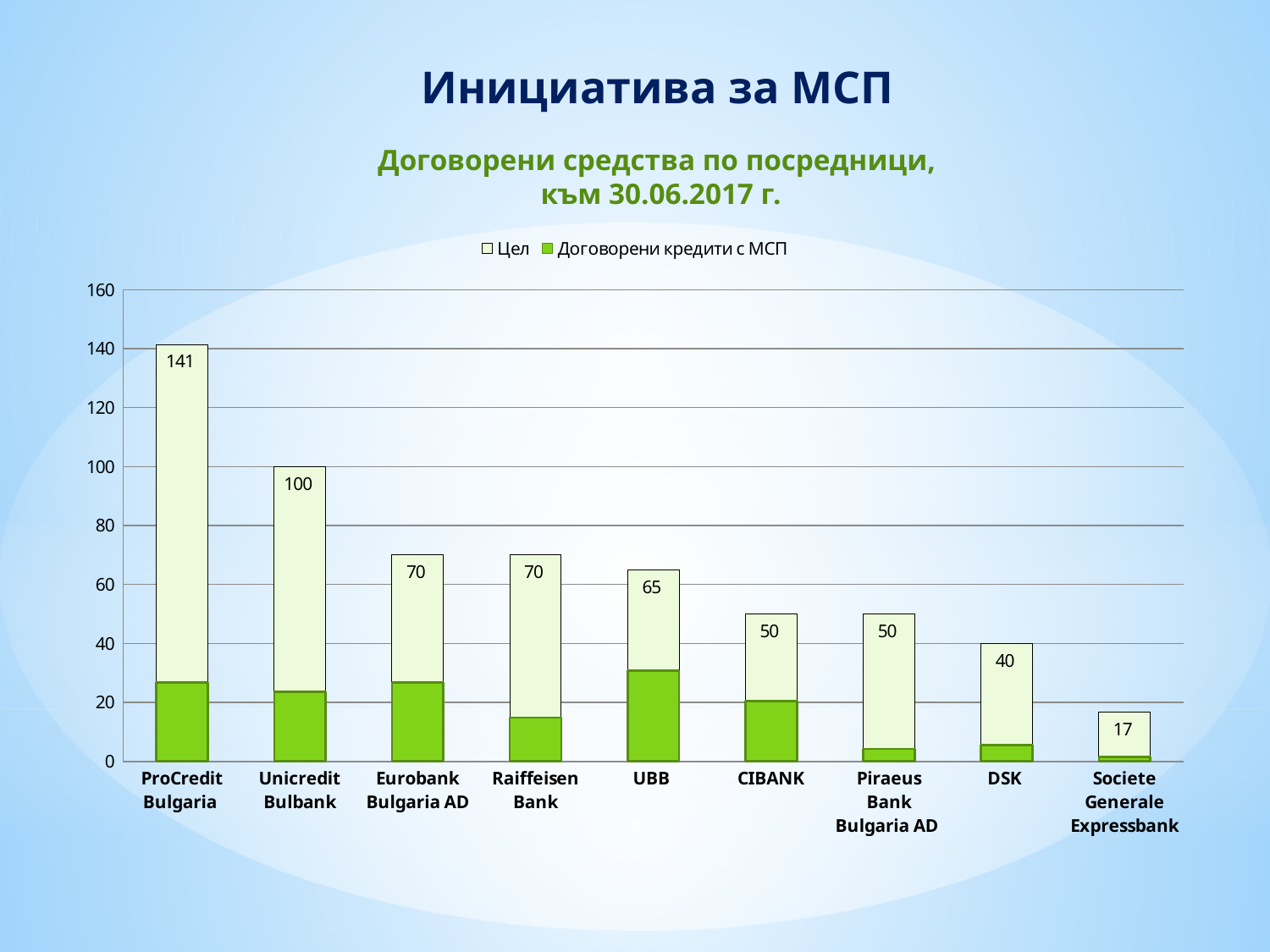
What is the Цел value for ProCredit Bulgaria? 141 Which has a larger Цел value, DSK or CIBANK? CIBANK How many banks are shown on the x axis of the chart? 9 What is the Цел value for UBB? 65 What kind of chart is shown on the slide? Bar chart Which bank has the highest Цел value? ProCredit Bulgaria How many series does the legend list? 2 Is the Договорени кредити с МСП value for UBB greater or less than 20? greater What is the Цел value for Societe Generale Expressbank? 17 Which bank has the lowest Цел value? Societe Generale Expressbank What is the difference between the Цел values for ProCredit Bulgaria and Unicredit Bulbank? 41 Is the Договорени кредити с МСП value for Piraeus Bank Bulgaria AD greater or less than 20? less